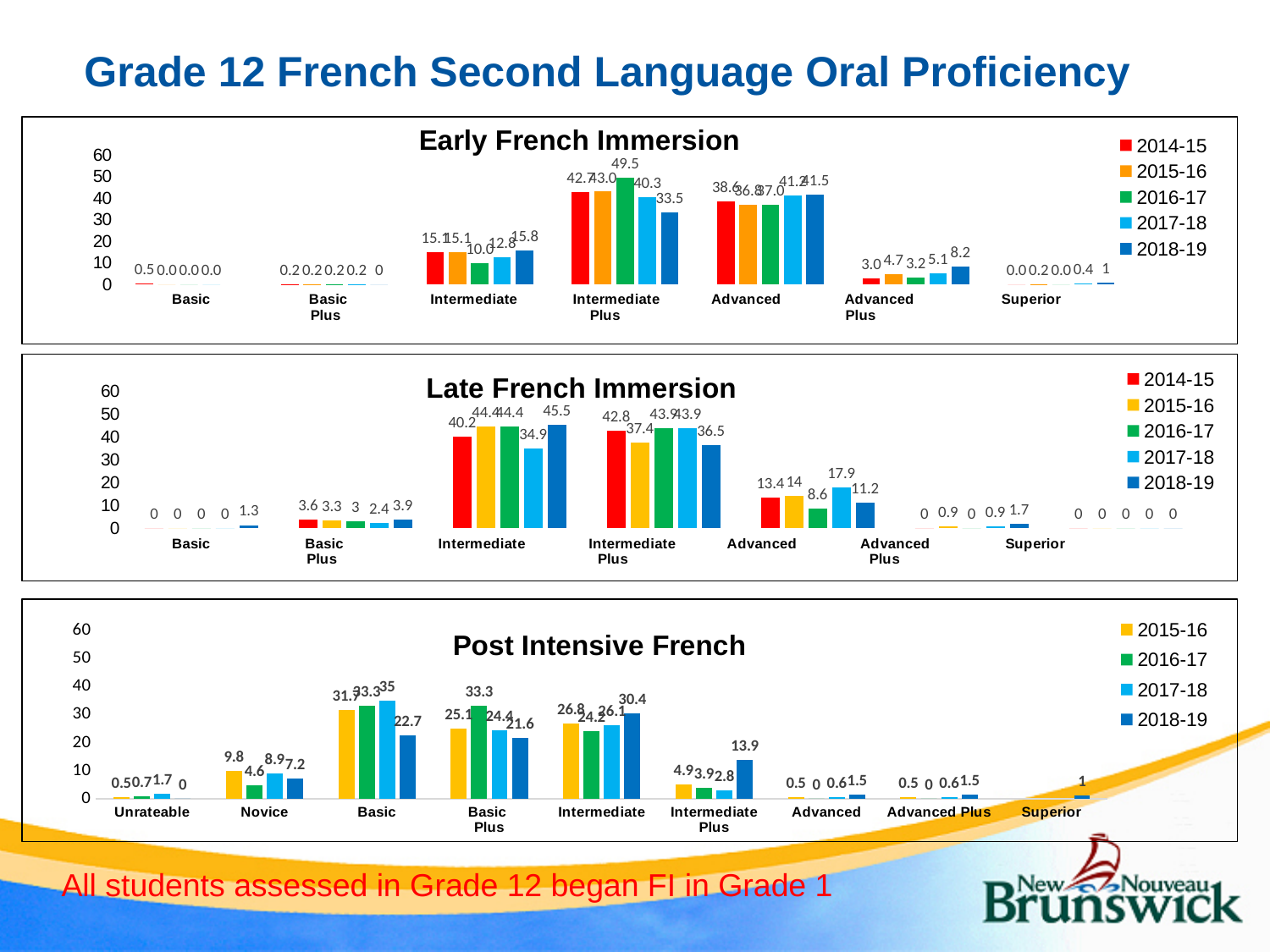
In the Post Intensive French chart, which is larger for the Basic category: the 2017-18 value or the 2018-19 value? 2017-18 In the Early French Immersion chart, is the 2018-19 value for Intermediate Plus greater or less than 40? less In the Early French Immersion chart, what is the value for 2018-19 in the Advanced Plus category? 8.2 In the Late French Immersion chart, which year has the highest value in the Intermediate category? 2018-19 In the Post Intensive French chart, what is the value for 2018-19 in the Intermediate Plus category? 13.9 How many categories are shown on the x axis of the Post Intensive French chart? 9 In the Late French Immersion chart, what is the value for 2017-18 in the Advanced category? 17.9 How many series does the legend of the Early French Immersion chart list? 5 In the Late French Immersion chart, what is the difference between the 2018-19 values for Intermediate and Intermediate Plus? 9 What kind of chart is the Post Intensive French chart? bar chart In the Early French Immersion chart, what is the value for 2016-17 in the Intermediate Plus category? 49.5 How many series does the legend of the Post Intensive French chart list? 4